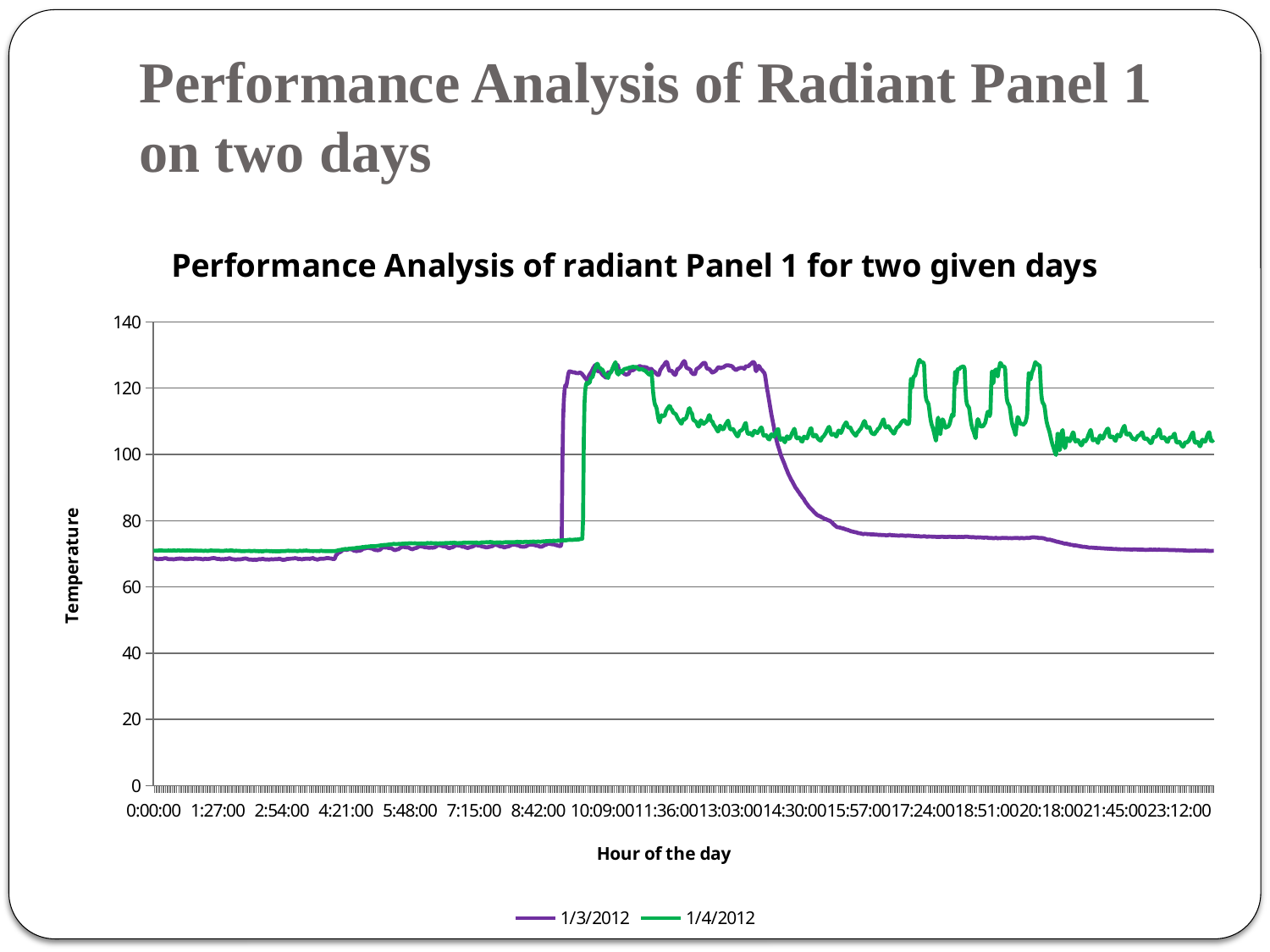
At 20:18:00, which series has the higher value, 1/3/2012 or 1/4/2012? 1/4/2012 Is the value for 1/3/2012 at 23:12:00 greater or less than 80? less Is the value for 1/4/2012 at 0:00:00 greater or less than 60? greater How many series does the legend list? 2 Is the value for 1/4/2012 at 23:12:00 greater or less than 100? greater What is the title of the chart? Performance Analysis of radiant Panel 1 for two given days Does the value for 1/4/2012 rise or fall between 8:42:00 and 10:09:00? rise What kind of chart is shown on the slide? line chart Does the value for 1/3/2012 rise or fall between 14:30:00 and 15:57:00? fall What is the label on the vertical axis of the chart? Temperature